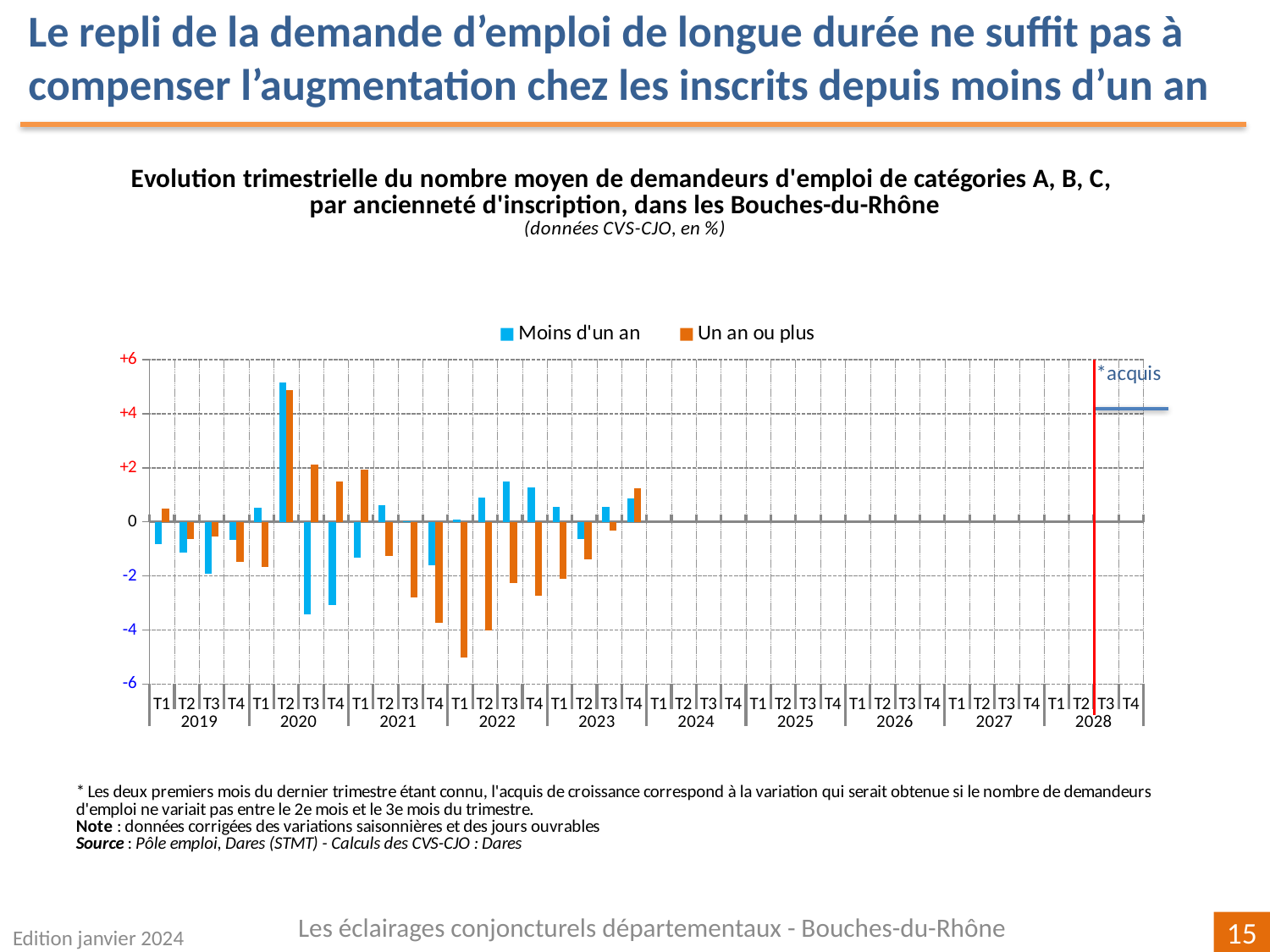
Is the value for 'Moins d'un an' in T3 2020 greater or less than -2? less Is the value for 'Moins d'un an' in T2 2020 greater or less than +4? greater In T4 2021, which series has the larger value, 'Moins d'un an' or 'Un an ou plus'? Moins d'un an What are the two series named in the legend? Moins d'un an; Un an ou plus In which quarter does the 'Moins d'un an' series reach its highest value? T2 2020 How many series does the legend list? 2 In T3 2020, which series has the larger value, 'Moins d'un an' or 'Un an ou plus'? Un an ou plus Is the value for 'Un an ou plus' in T1 2022 greater or less than -4? less In which quarter does the 'Un an ou plus' series reach its highest value? T2 2020 What kind of chart is shown on the slide? bar chart Which series is drawn in orange? Un an ou plus In which quarter does the 'Un an ou plus' series reach its lowest value? T1 2022